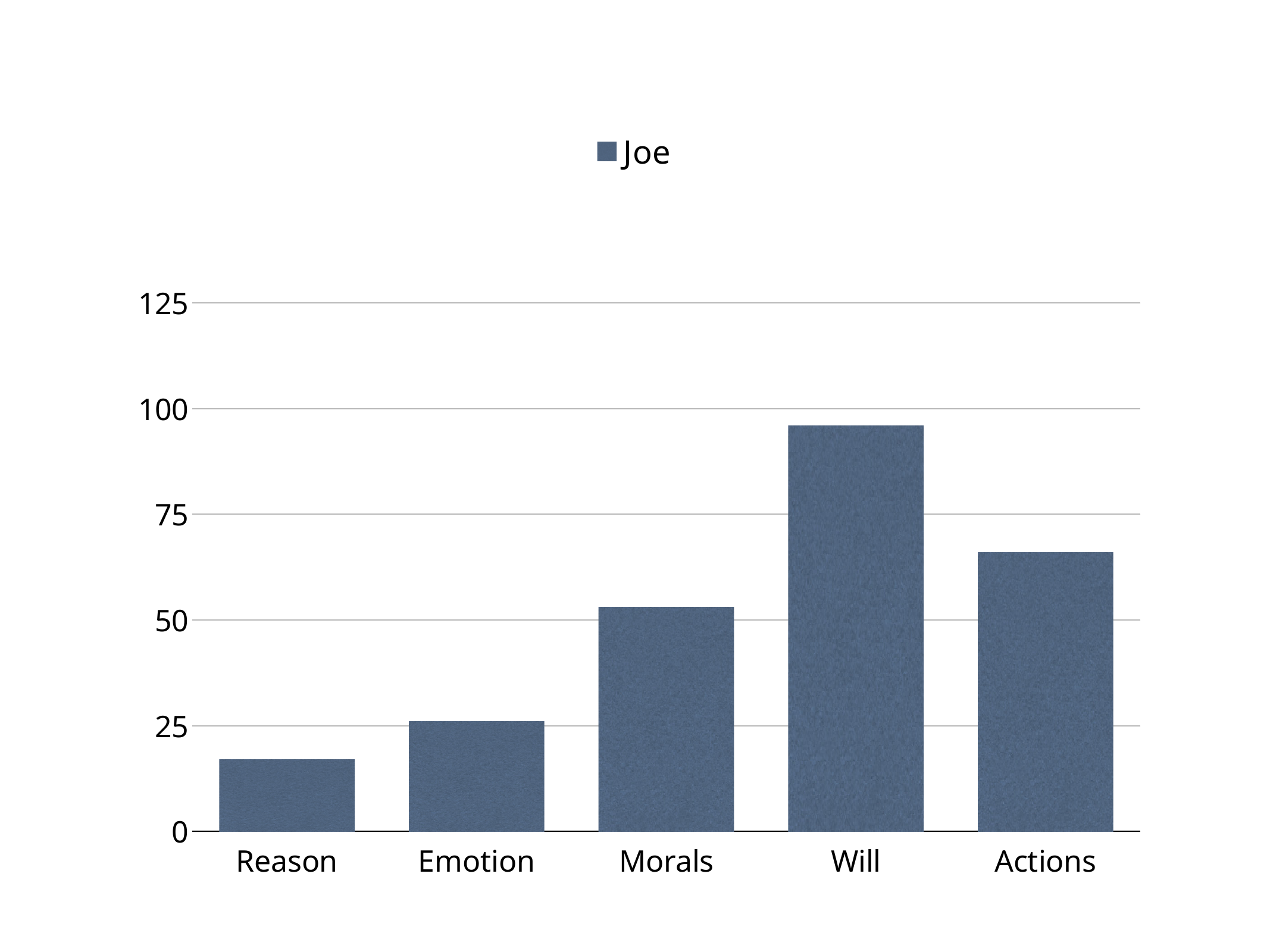
How many series does the legend list? 1 Which category has the lowest value? Reason Is the value for Reason greater or less than 25? less Is the value for Actions greater or less than 75? less Which is larger, the value for Emotion or the value for Reason? Emotion What kind of chart is shown on the slide? bar chart Is the value for Will greater or less than 75? greater Which is larger, the value for Morals or the value for Actions? Actions Which category has the highest value? Will What is the name of the series shown in the legend? Joe How many categories are shown on the x axis? 5